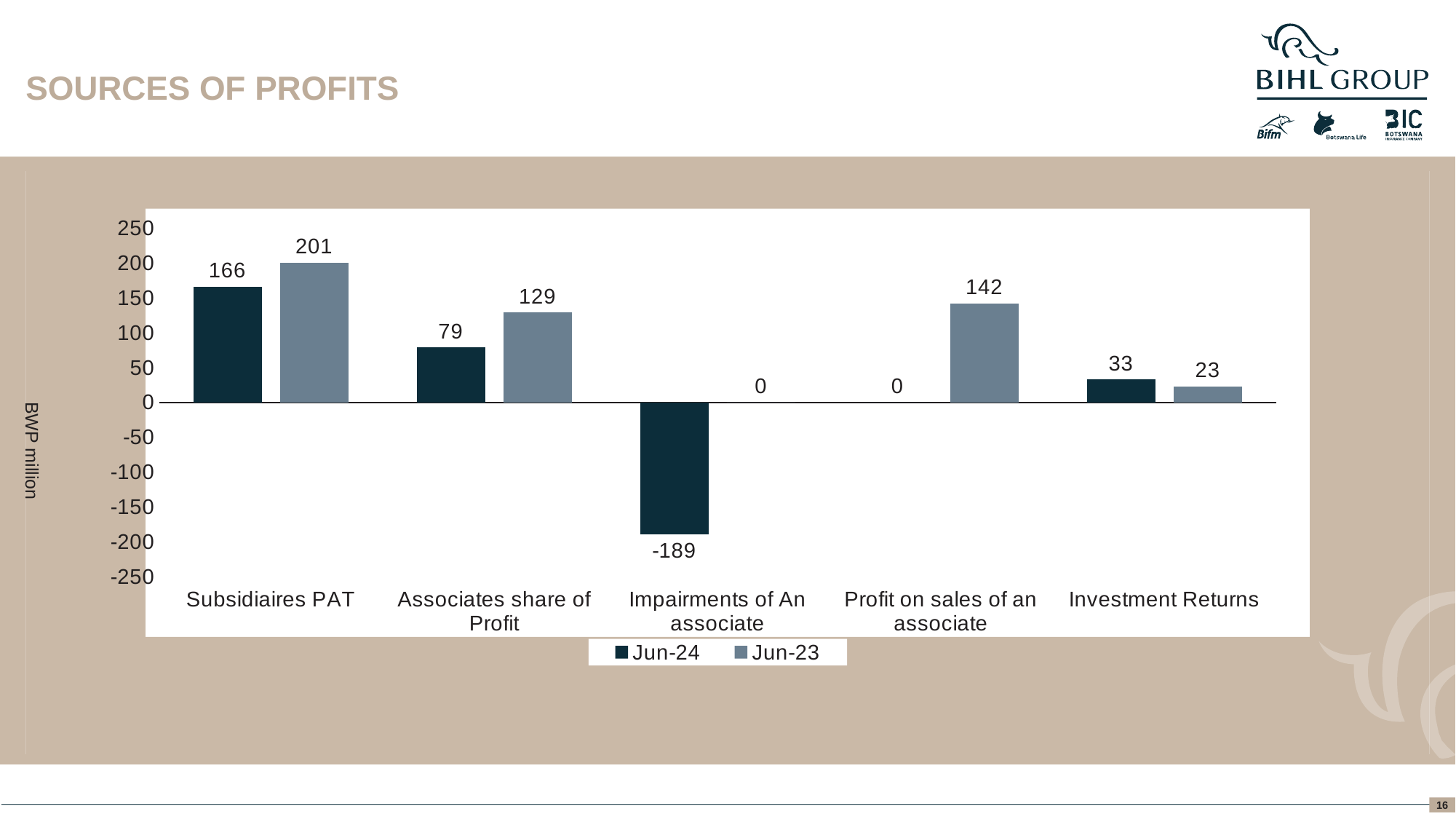
How many series does the legend list? 2 What kind of chart is shown on the slide? Bar chart What is the Jun-24 value for Impairments of An associate? -189 How many categories are shown on the x axis? 5 Which category has the highest Jun-23 value? Subsidiaires PAT What is the Jun-23 value for Associates share of Profit? 129 For Investment Returns, which is larger: the Jun-24 value or the Jun-23 value? Jun-24 What is the Jun-24 value for Subsidiaires PAT? 166 What is the label on the vertical axis? BWP million Which category has the lowest Jun-24 value? Impairments of An associate What is the Jun-23 value for Profit on sales of an associate? 142 What is the difference between the Jun-23 and Jun-24 values for Subsidiaires PAT? 35